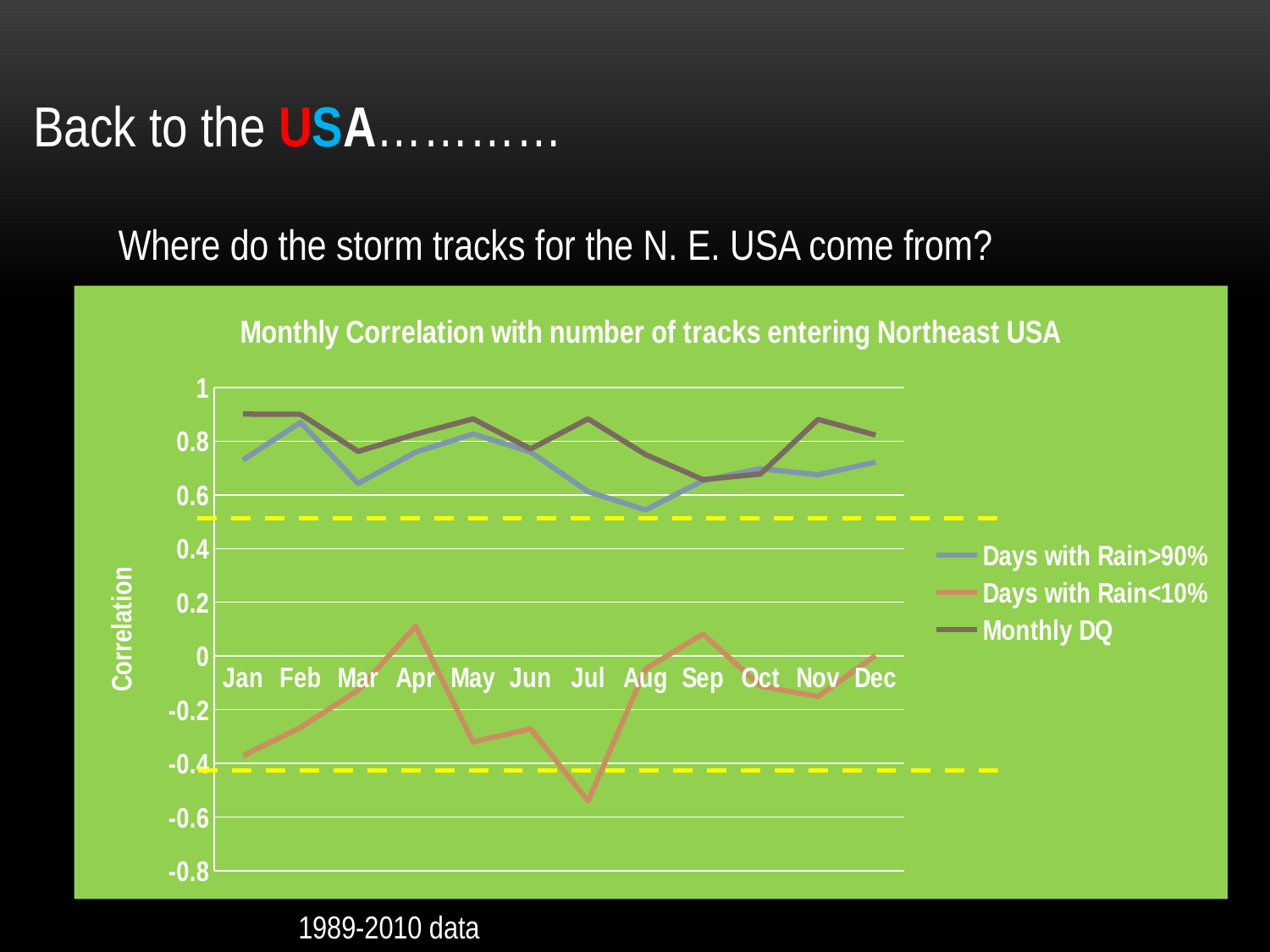
In Jan, which series has the larger value: Monthly DQ or Days with Rain>90%? Monthly DQ How many series does the legend list? 3 How many months are plotted along the x axis? 12 In which month is the Days with Rain<10% series lowest? Jul Is the value for Monthly DQ in Jan greater or less than 0.8? greater What is the title of the chart? Monthly Correlation with number of tracks entering Northeast USA Does the Days with Rain<10% series rise or fall from Jan to Apr? rise In which month is the Days with Rain>90% series highest? Feb What is the label on the vertical axis? Correlation Is the value for Days with Rain<10% in Apr greater or less than 0? greater What kind of chart is shown on the slide? line chart Is the value for Days with Rain<10% in Jul greater or less than -0.4? less